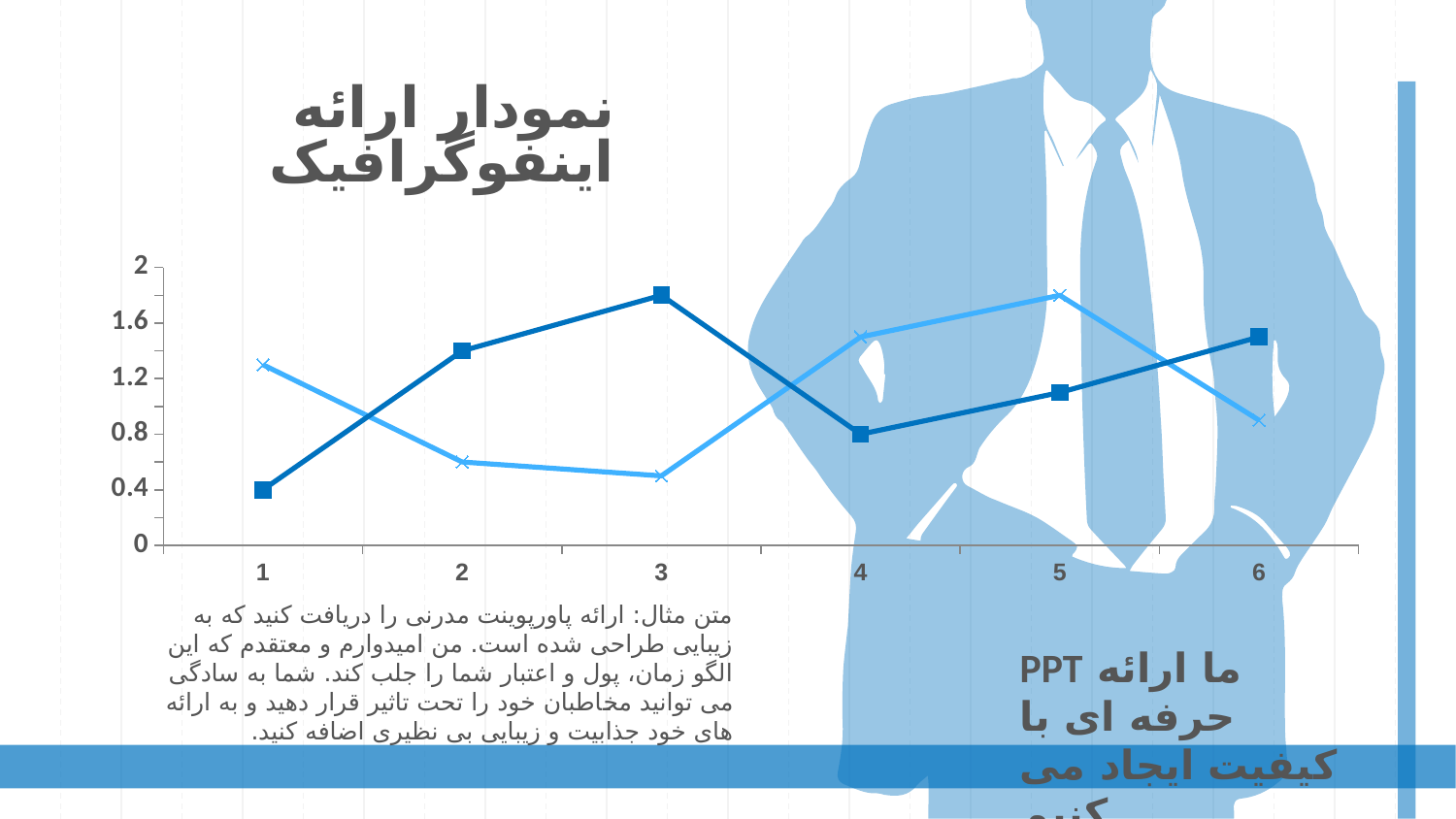
How many series are plotted on the chart? 2 At x = 1, which series has the higher value, the dark blue (square markers) or the light blue (x markers)? light blue (x markers) What kind of chart is shown on the slide? line chart Is the value of the light blue series (x markers) at x = 3 greater or less than 0.8? less At which x value does the light blue series (x markers) reach its lowest point? 3 How many points are plotted along the x axis for each series? 6 At which x value does the dark blue series (square markers) reach its highest point? 3 Is the value of the dark blue series (square markers) at x = 3 greater or less than 1.6? greater Does the light blue series (x markers) rise or fall from x = 5 to x = 6? fall Is the value of the light blue series (x markers) at x = 5 greater or less than 1.6? greater Does the dark blue series (square markers) rise or fall from x = 1 to x = 3? rise At which x value does the dark blue series (square markers) reach its lowest point? 1